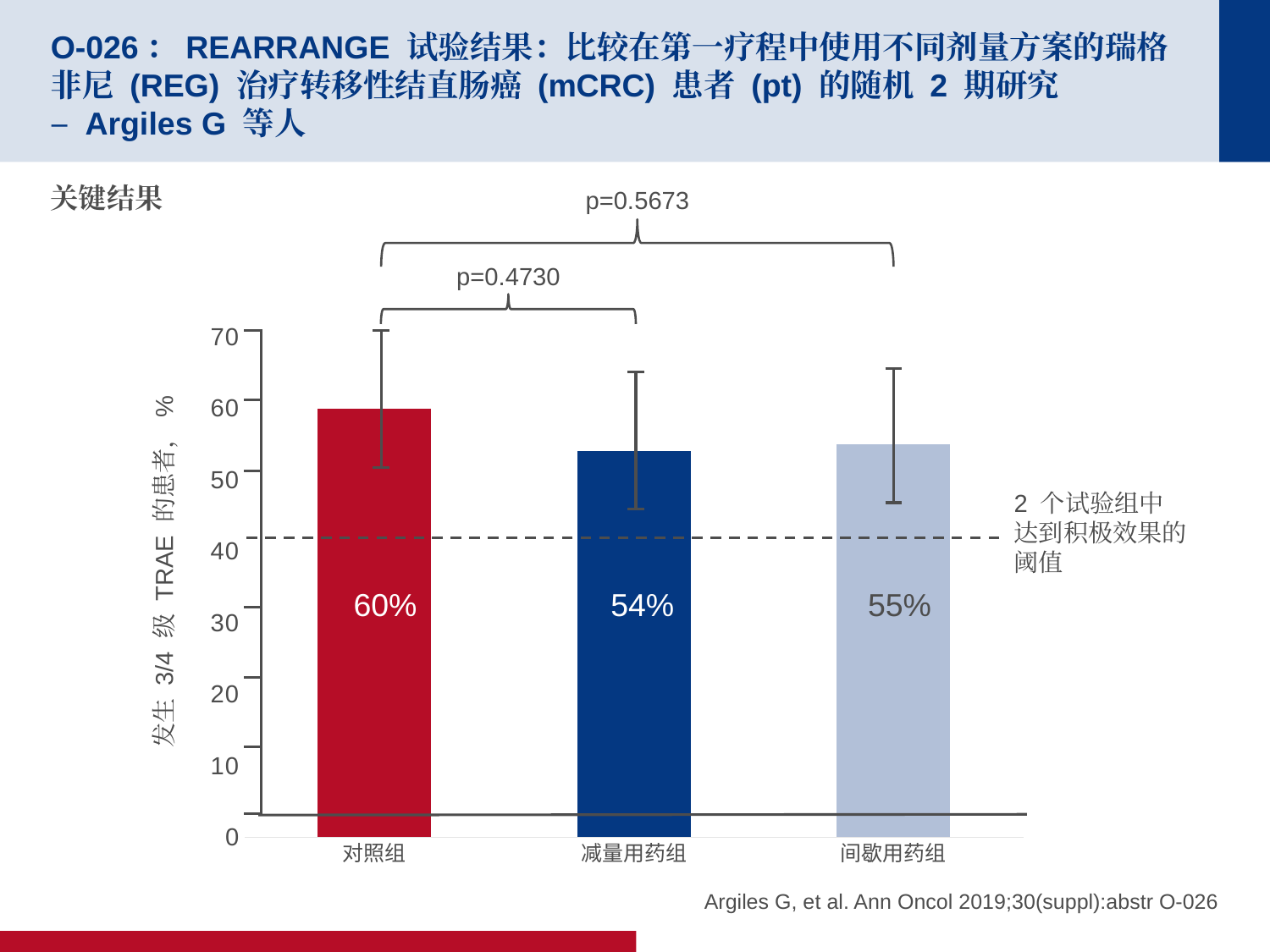
What is the value for 减量用药组? 54% Which group has the highest percentage of patients with grade 3/4 TRAE? 对照组 What is the value for 间歇用药组? 55% Which is larger, the value for 间歇用药组 or the value for 减量用药组? 间歇用药组 What p-value is shown for the comparison between 对照组 and 间歇用药组? p=0.5673 What is the difference between the values for 对照组 and 减量用药组? 6% What kind of chart is shown on the slide? bar chart Which group has the lowest percentage of patients with grade 3/4 TRAE? 减量用药组 What p-value is shown for the comparison between 对照组 and 减量用药组? p=0.4730 How many groups are shown on the x axis? 3 What is the value for 对照组? 60% Is the value for 对照组 greater or less than 50? greater